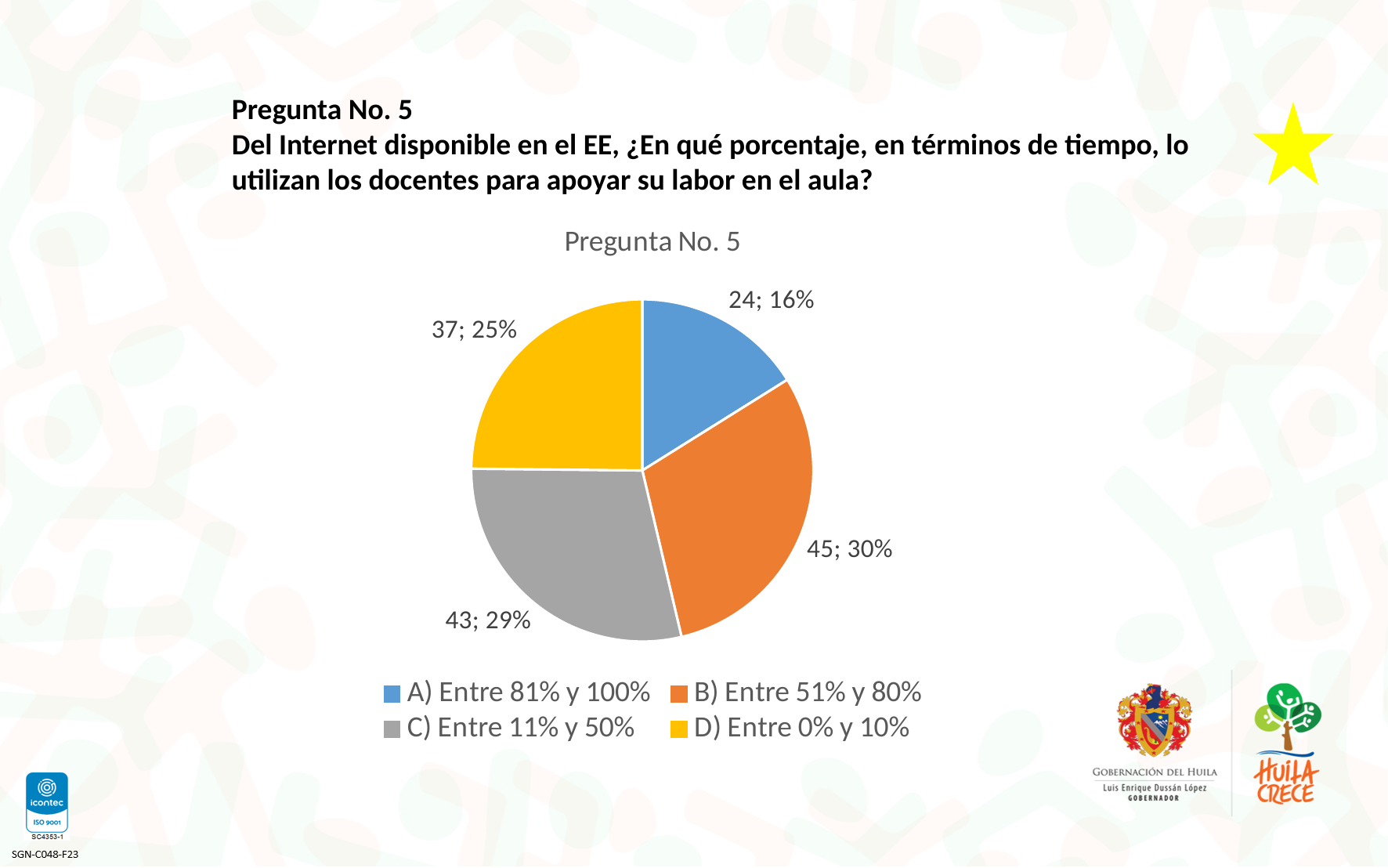
What is the count for the slice "A) Entre 81% y 100%"? 24 What percentage share does the slice "C) Entre 11% y 50%" have? 29% What is the difference between the counts for "B) Entre 51% y 80%" and "A) Entre 81% y 100%"? 21 Which has a larger count: "C) Entre 11% y 50%" or "D) Entre 0% y 10%"? C) Entre 11% y 50% What is the count for the slice "B) Entre 51% y 80%"? 45 Which category has the smallest slice of the pie? A) Entre 81% y 100% What is the title of the chart? Pregunta No. 5 What percentage share does the slice "B) Entre 51% y 80%" have? 30% What type of chart is shown on the slide? Pie chart What is the count for the slice "D) Entre 0% y 10%"? 37 Which category has the largest slice of the pie? B) Entre 51% y 80% How many slices does the pie chart have? 4